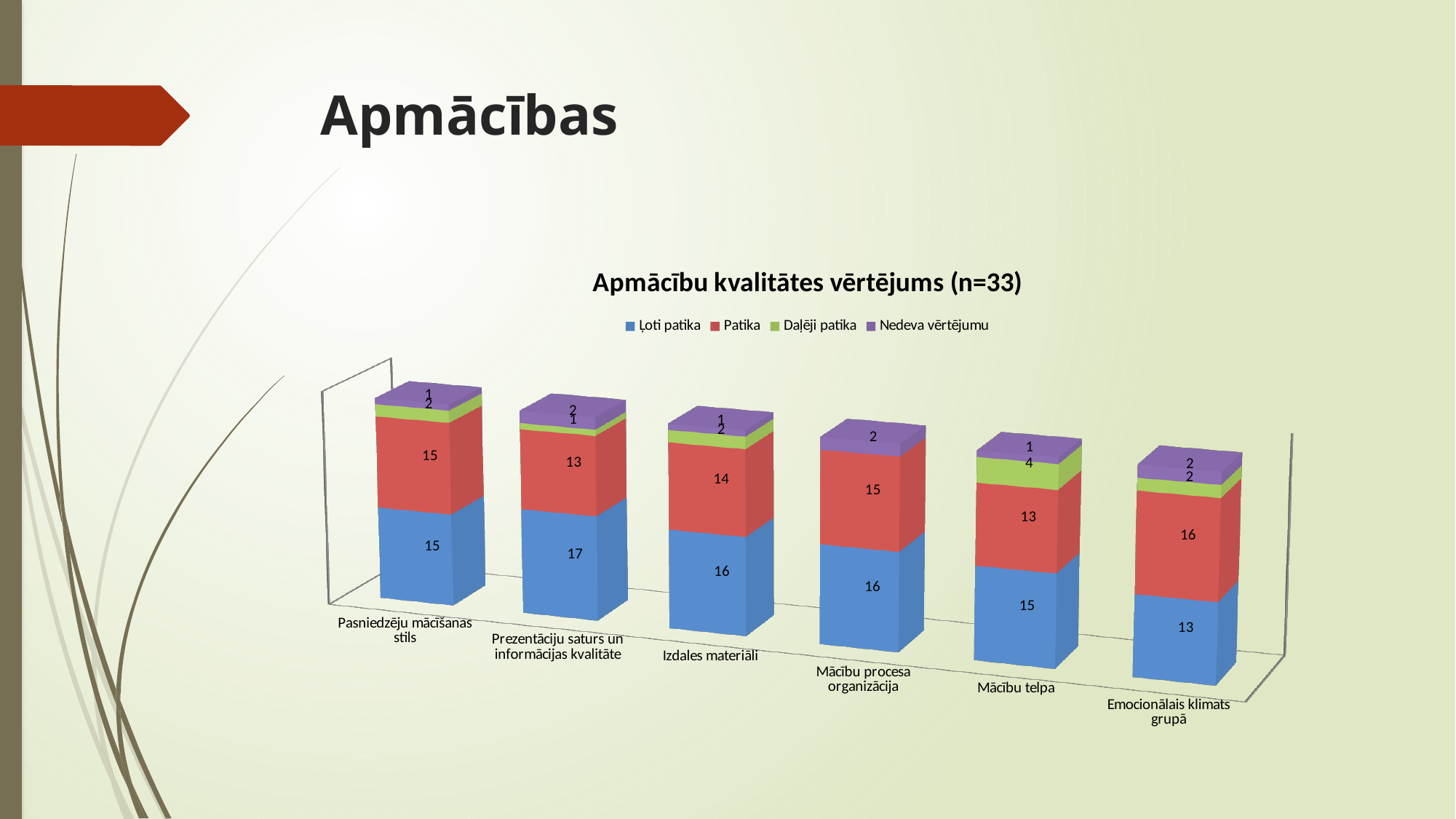
What is the difference between the "Ļoti patika" values for "Prezentāciju saturs un informācijas kvalitāte" and "Emocionālais klimats grupā"? 4 Which is larger: the "Patika" value for "Mācību procesa organizācija" or for "Mācību telpa"? Mācību procesa organizācija Which category has the lowest value for "Ļoti patika"? Emocionālais klimats grupā What is the title of the chart? Apmācību kvalitātes vērtējums (n=33) What is the value of "Daļēji patika" for "Mācību telpa"? 4 What is the value of "Patika" for "Emocionālais klimats grupā"? 16 What kind of chart is shown on the slide? Stacked bar chart Which category has the highest value for "Ļoti patika"? Prezentāciju saturs un informācijas kvalitāte How many series does the legend list? 4 What is the total of the stacked bar for "Mācību telpa"? 33 How many categories are shown on the x axis? 6 What is the value of "Ļoti patika" for "Prezentāciju saturs un informācijas kvalitāte"? 17